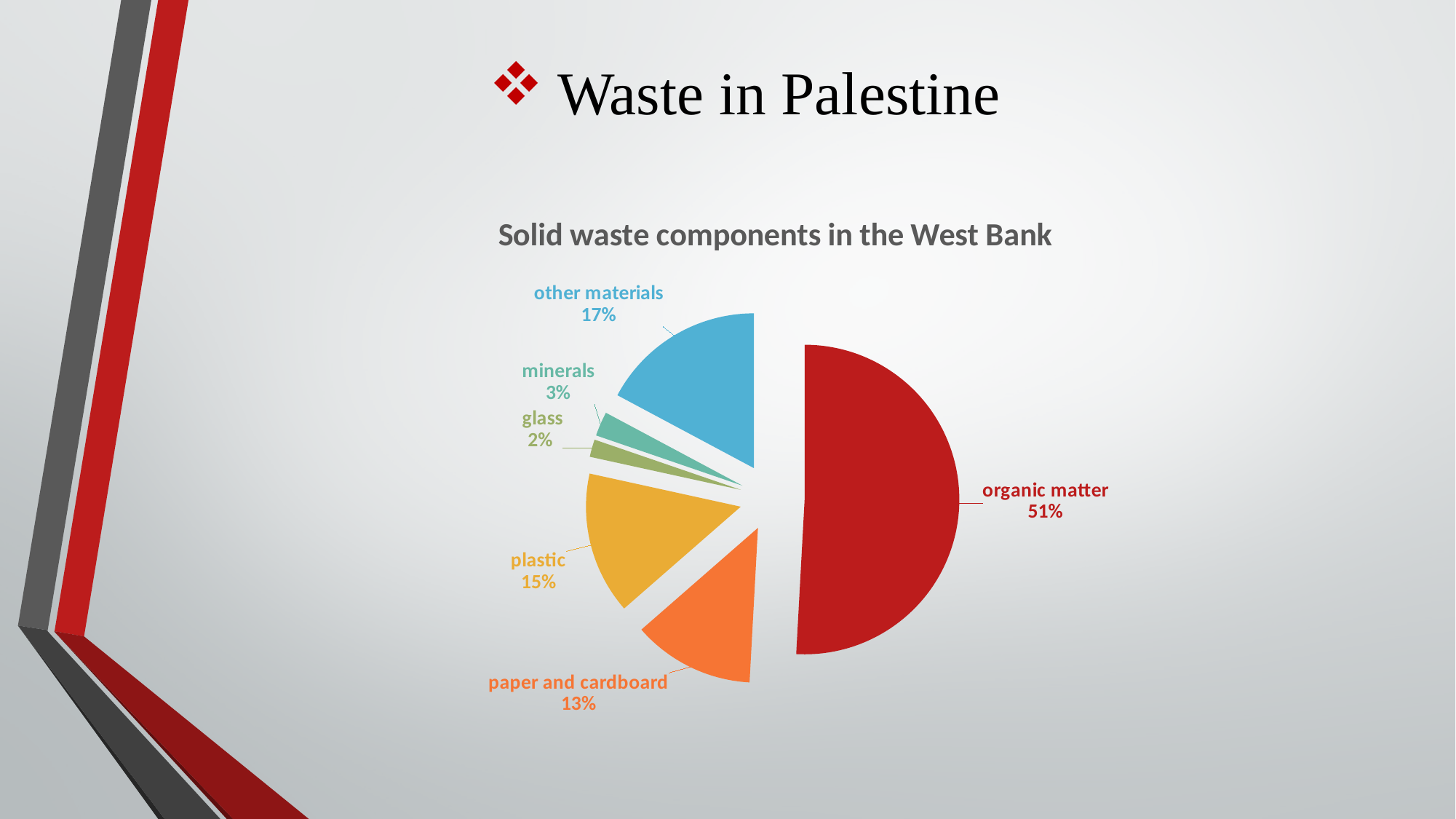
How many slices does the pie chart have? 6 What share of the pie is plastic? 15% What percentage is shown for paper and cardboard? 13% What type of chart is shown on the slide? pie chart What colour is the organic matter slice? red What percentage of solid waste is organic matter? 51% What is the difference in percentage points between other materials and plastic? 2 What percentage is shown for other materials? 17% Which component has the largest share of solid waste? organic matter What is the title of the chart? Solid waste components in the West Bank Which component has the smallest share of solid waste? glass Which is larger, the share for minerals or the share for glass? minerals